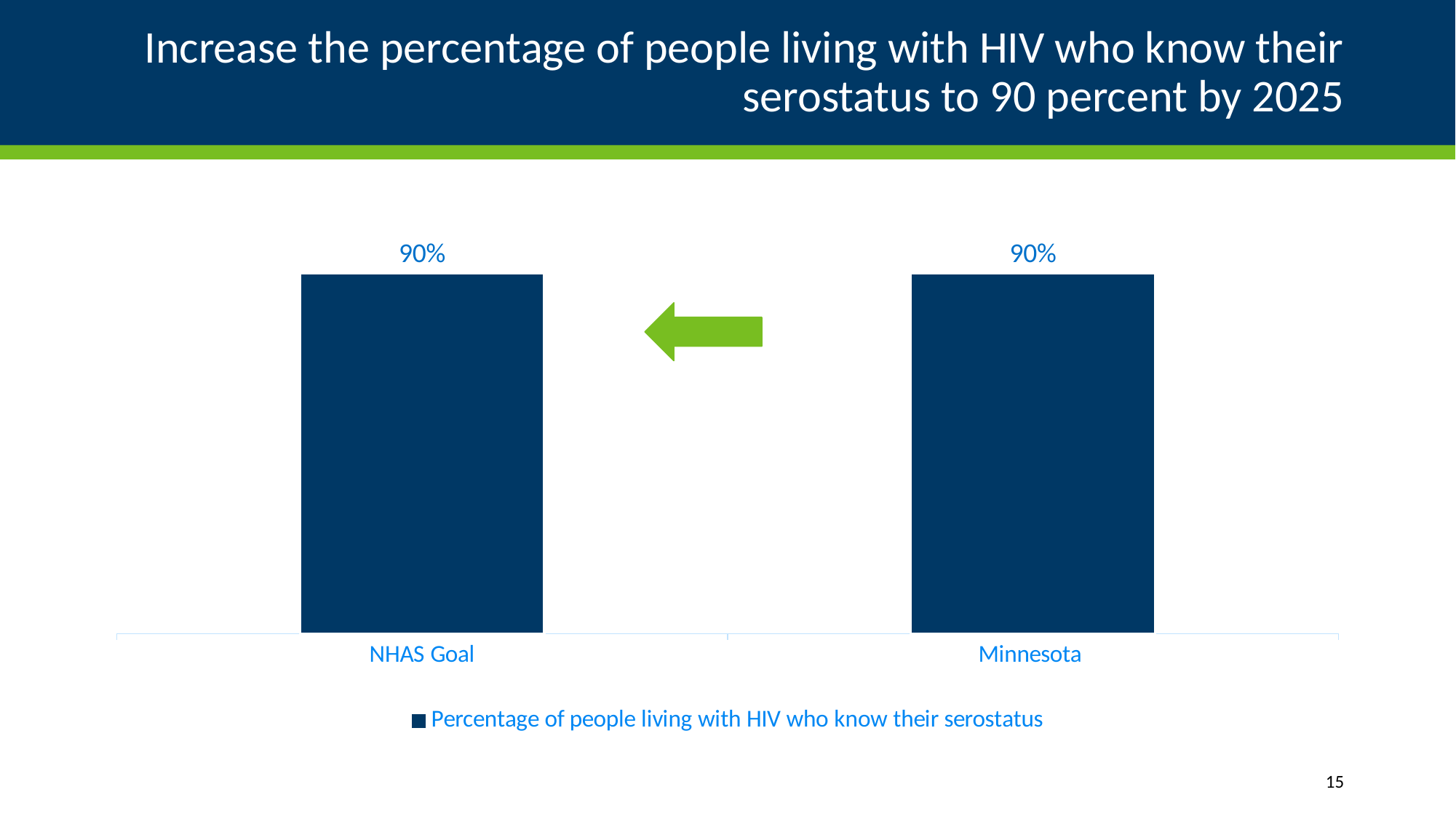
What kind of chart is shown on the slide? bar chart How many categories are shown on the x axis? 2 How many series does the legend list? 1 Is the value for Minnesota equal to the value for NHAS Goal? Yes What is the value for Minnesota? 90% What is the difference between the values for NHAS Goal and Minnesota? 0% What series name does the legend show? Percentage of people living with HIV who know their serostatus What is the value for NHAS Goal? 90% What are the two category labels on the x axis? NHAS Goal, Minnesota